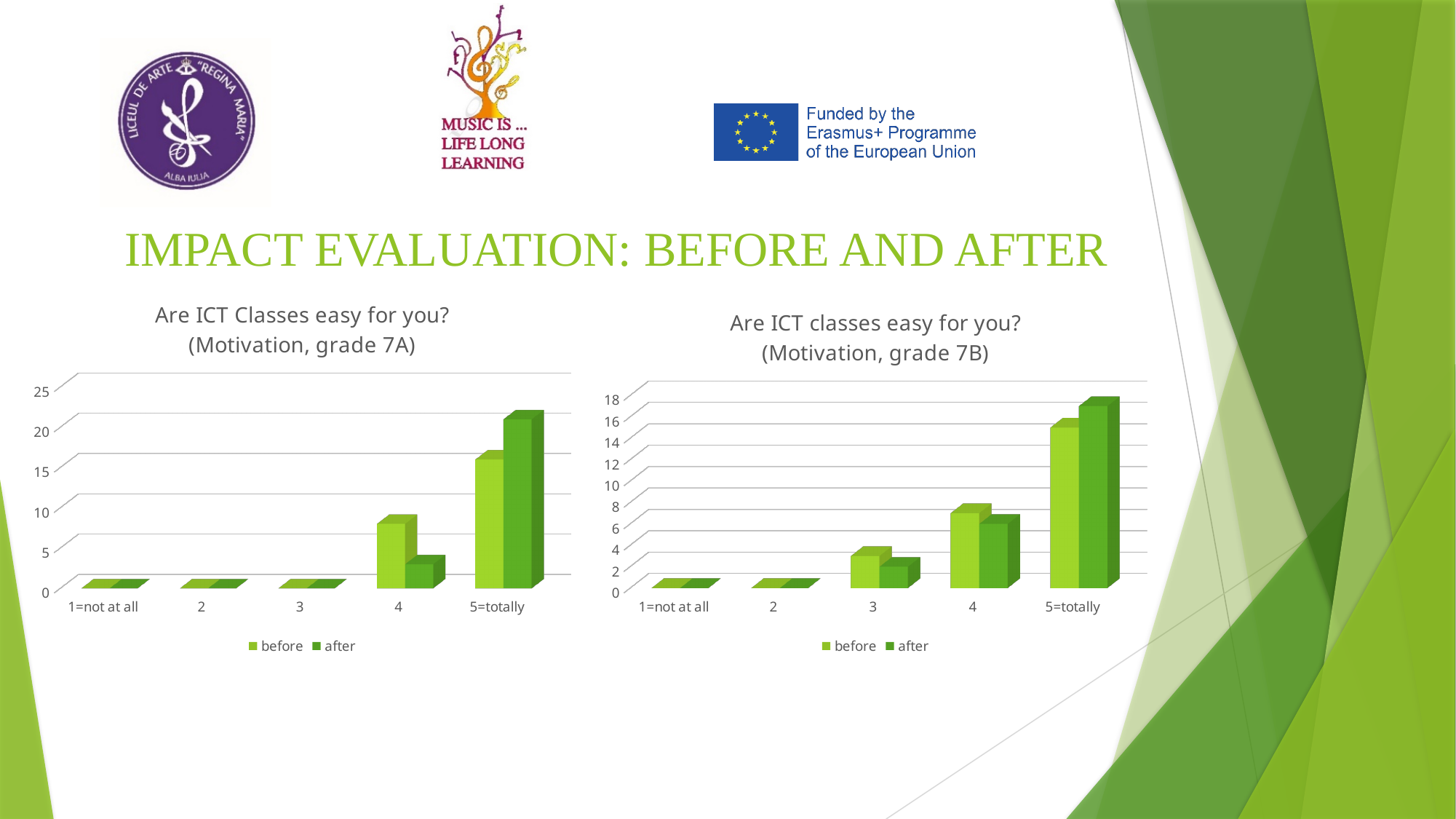
In the left chart (Motivation, grade 7A), which is larger for category 4: the 'before' value or the 'after' value? before In the left chart (Motivation, grade 7A), is the 'before' value for category 4 greater or less than 5? greater What kind of chart is the left chart (Motivation, grade 7A)? bar chart In the left chart (Motivation, grade 7A), is the 'after' value for category 4 greater or less than 5? less In the left chart (Motivation, grade 7A), which is larger for '5=totally': the 'before' value or the 'after' value? after How many series does the legend of the left chart (Motivation, grade 7A) list? 2 In the right chart (Motivation, grade 7B), is the 'after' value for '5=totally' greater or less than 14? greater In the right chart (Motivation, grade 7B), which is larger for '5=totally': the 'before' value or the 'after' value? after How many categories are shown on the x axis of the right chart (Motivation, grade 7B)? 5 In the left chart (Motivation, grade 7A), which category has the highest 'after' value? 5=totally